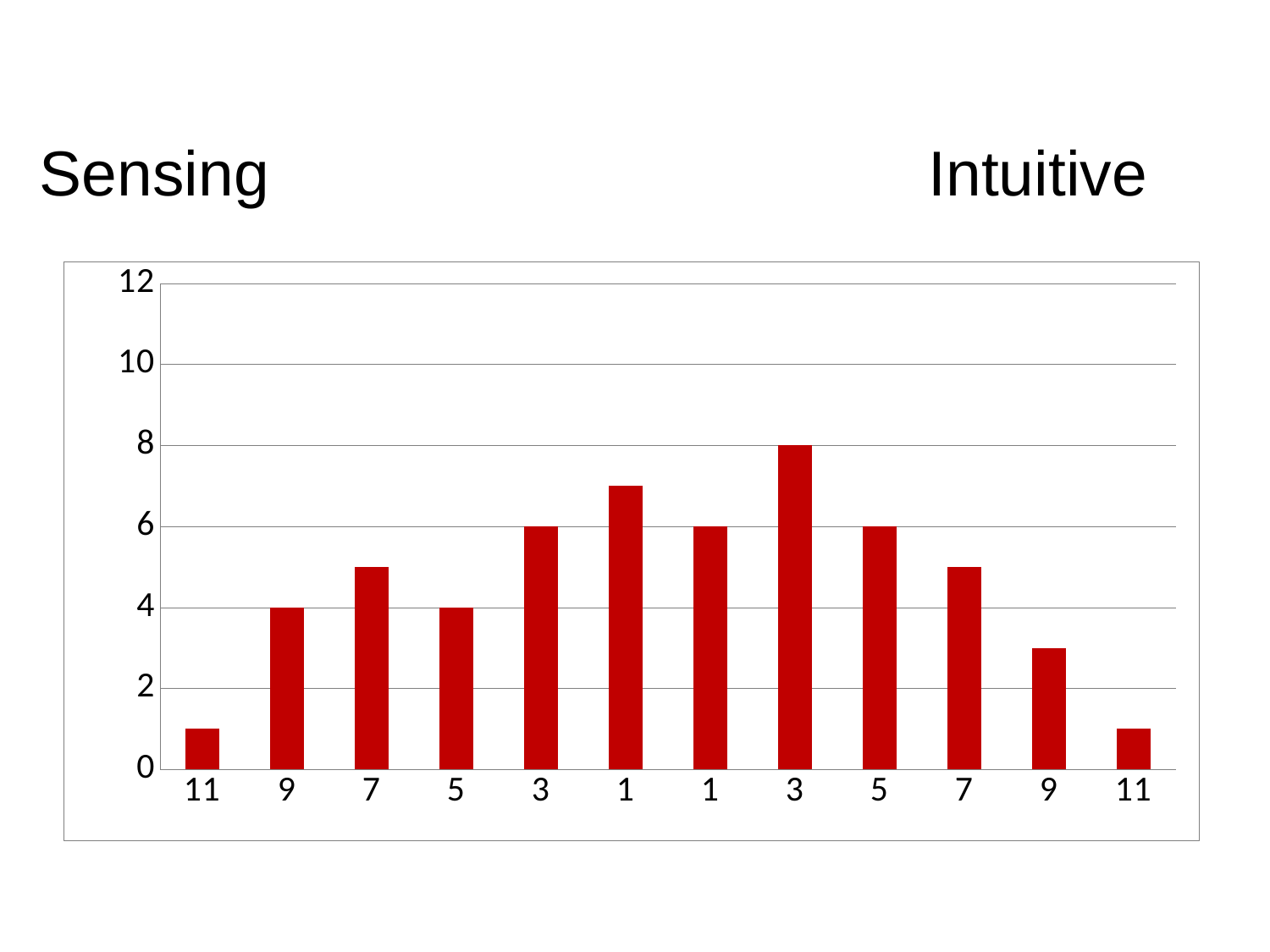
What type of chart is shown on the slide? bar chart How many bars are plotted in the chart? 12 Which bar is the highest in the chart? 3 on the Intuitive side Which is larger: the bar labelled 1 on the Sensing side or the bar labelled 3 on the Intuitive side? 3 on the Intuitive side What is the value of the bar labelled 3 on the Sensing side? 6 What is the difference between the bar labelled 3 on the Intuitive side and the bar labelled 9 on the Sensing side? 4 Is the value for the bar labelled 1 on the Sensing side greater or less than 6? greater What is the value of the bar labelled 9 on the Sensing side? 4 Is the value for the bar labelled 9 on the Intuitive side greater or less than 4? less What is the value of the bar labelled 3 on the Intuitive side? 8 What is the value of the bar labelled 5 on the Intuitive side? 6 What is the highest value shown on the vertical axis? 12